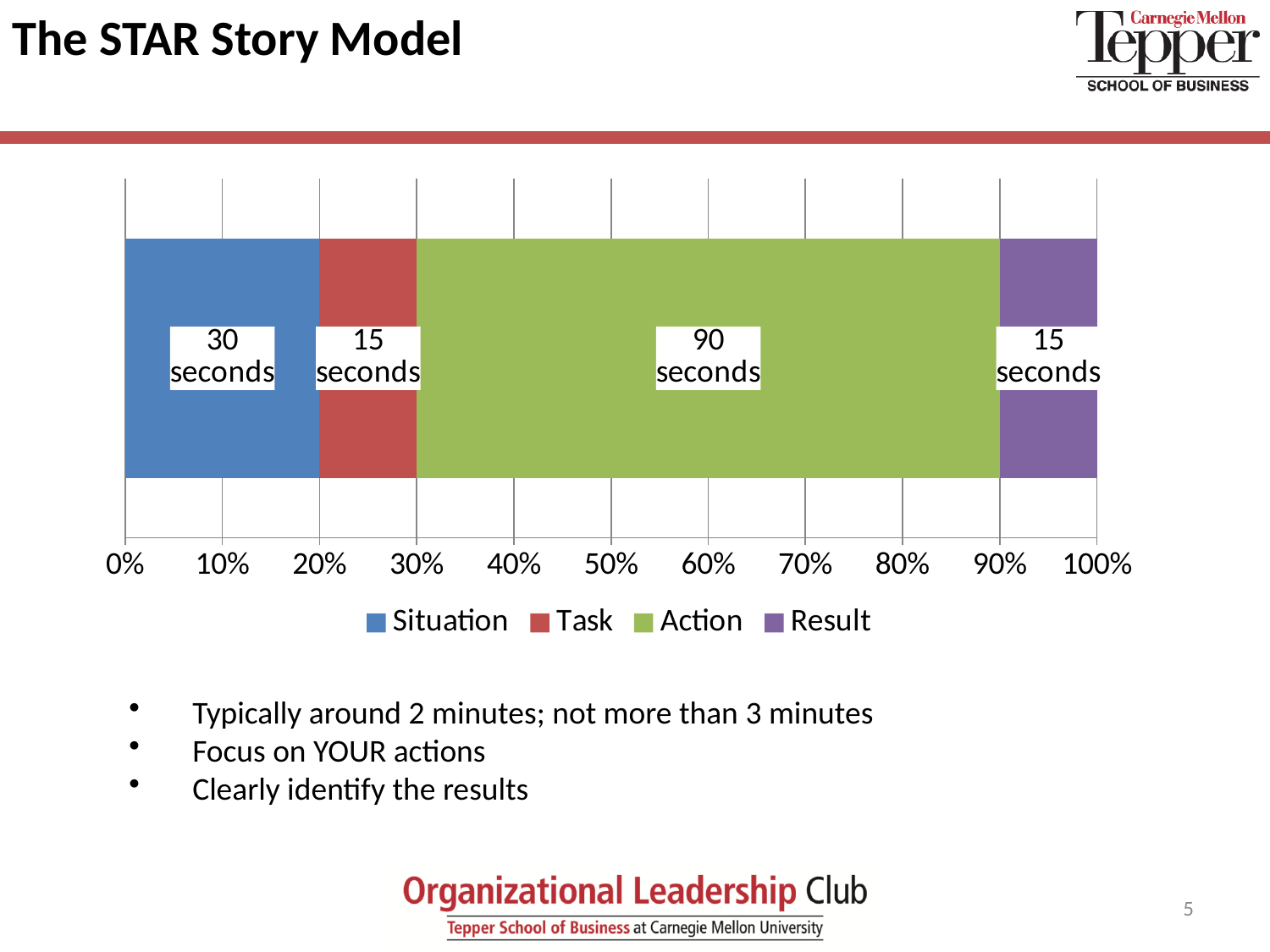
How many series does the legend list? 4 What is the value shown for the Action segment? 90 seconds How many seconds longer is the Action segment than the Situation segment? 60 seconds Which is larger, the Situation segment or the Task segment? Situation What is the value shown for the Situation segment? 30 seconds What is the total of all four segments in the stacked bar? 150 seconds What colour is the Action segment in the chart? Green Which segment of the bar has the largest value? Action What is the value shown for the Task segment? 15 seconds What percentage of the full bar does the Action segment occupy, according to the x axis? 60% What is the value shown for the Result segment? 15 seconds What kind of chart is shown on the slide? Stacked bar chart